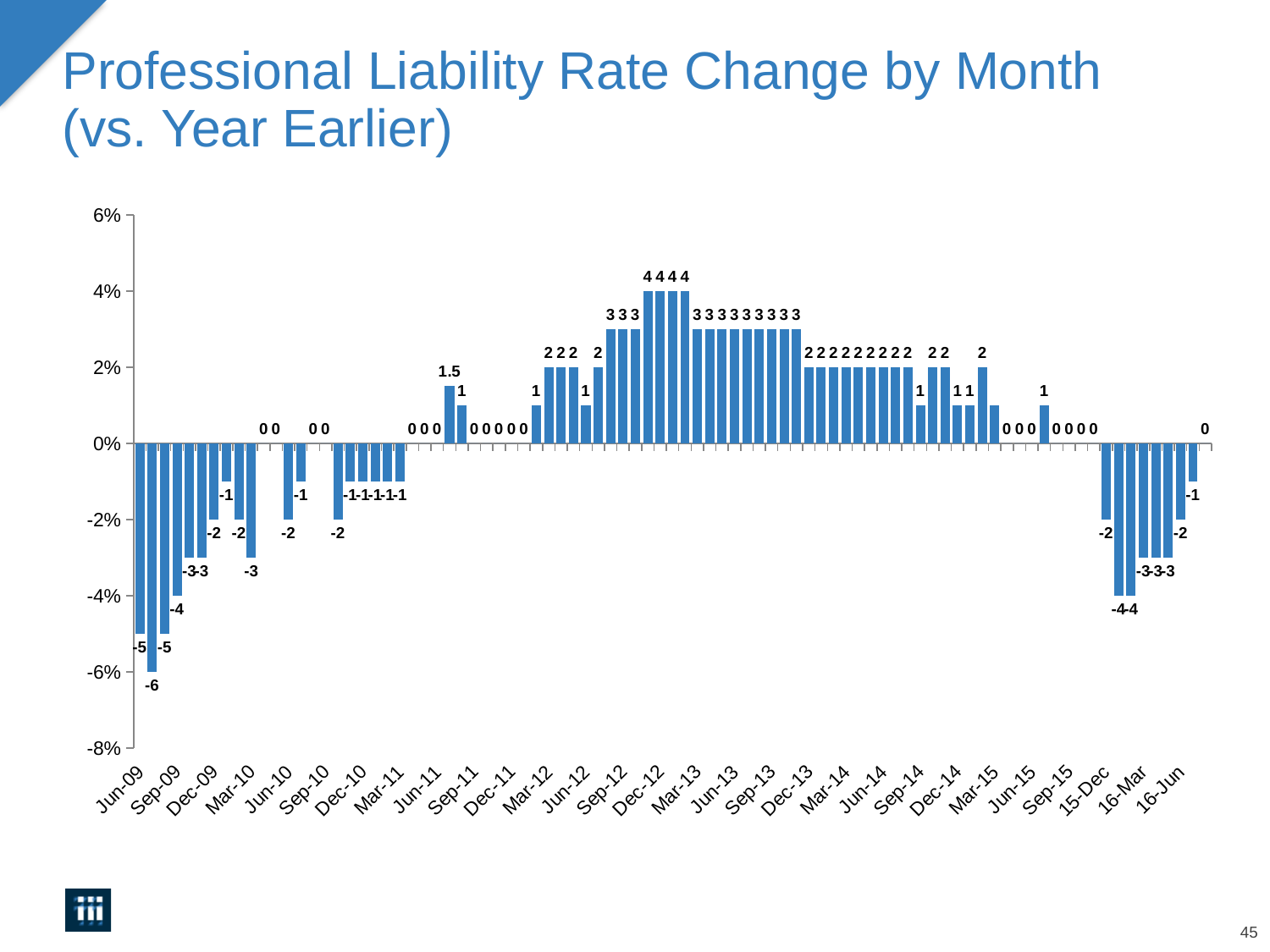
Do the values generally rise or fall from Jun-09 to Dec-12? rise How many bars are labeled with the value 4? 4 Is the value for Jun-09 greater or less than -4%? less Which is larger, the value for Jun-09 or the value for 16-Jun? 16-Jun What kind of chart is shown on the slide? bar chart What is the title of the chart? Professional Liability Rate Change by Month (vs. Year Earlier) What is the value of the first bar, for Jun-09? -5 What is the lowest value labeled on any bar in the chart? -6 What is the highest value shown on the vertical axis? 6% What is the difference between the highest bar value (4) and the lowest bar value (-6)? 10 What is the highest value labeled on any bar in the chart? 4